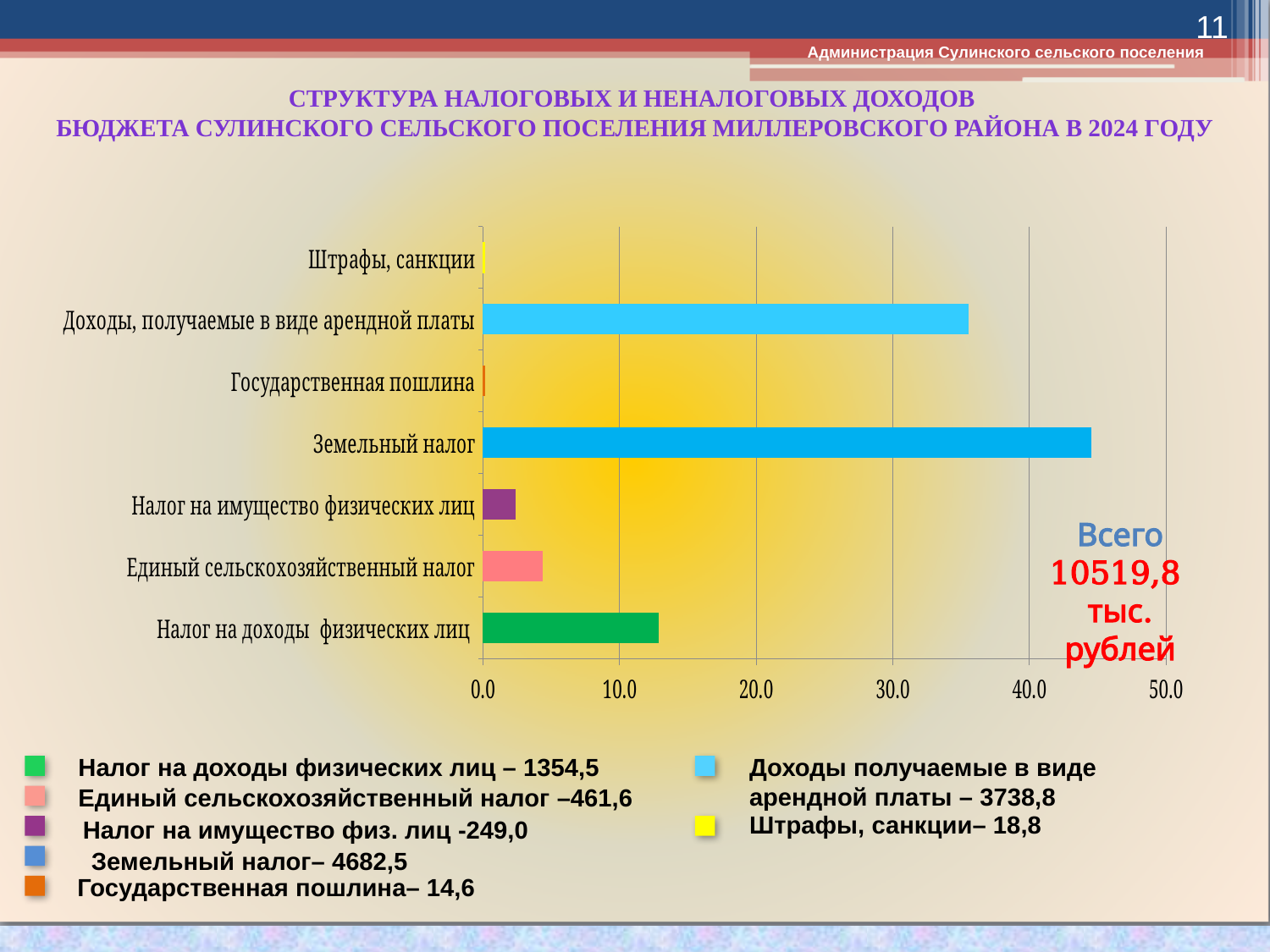
Using the legend amounts, what is the difference between Земельный налог and Доходы получаемые в виде арендной платы? 943,7 What kind of chart is shown on the slide? bar chart According to the legend, which revenue item has the smallest amount? Государственная пошлина – 14,6 What total amount (Всего) is stated on the slide? 10519,8 тыс. рублей How many categories are plotted in the chart? 7 What amount does the legend give for Доходы получаемые в виде арендной платы? 3738,8 Which bar is longer: Единый сельскохозяйственный налог or Налог на имущество физических лиц? Единый сельскохозяйственный налог Is the bar value for Доходы, получаемые в виде арендной платы greater or less than 40.0? less What amount does the legend give for Налог на доходы физических лиц? 1354,5 Is the bar value for Земельный налог greater or less than 40.0? greater Which category has the longest bar in the chart? Земельный налог What amount does the legend give for Земельный налог? 4682,5